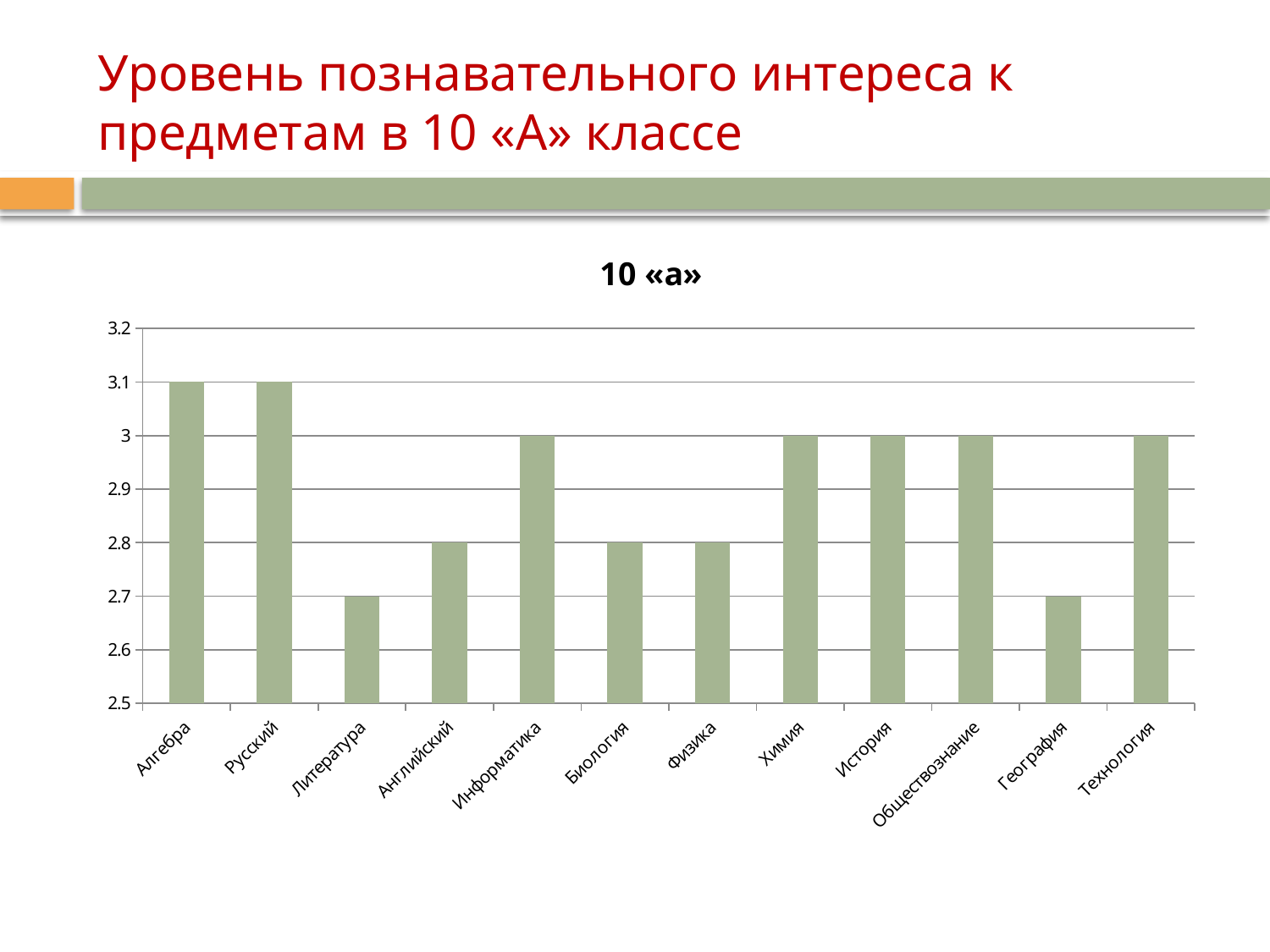
What type of chart is shown on the slide? bar chart Which is larger, the value for Биология or the value for Химия? Химия Which is larger, the value for Русский or the value for Английский? Русский What is the title of the chart? 10 «а» What is the difference between the value for Алгебра and the value for Литература? 0.4 What is the value for Физика? 2.8 What is the value for Алгебра? 3.1 What is the value for Литература? 2.7 How many subjects (categories) are shown on the x axis? 12 What is the value for Информатика? 3 Is the value for История greater or less than 2.9? greater What is the value for География? 2.7